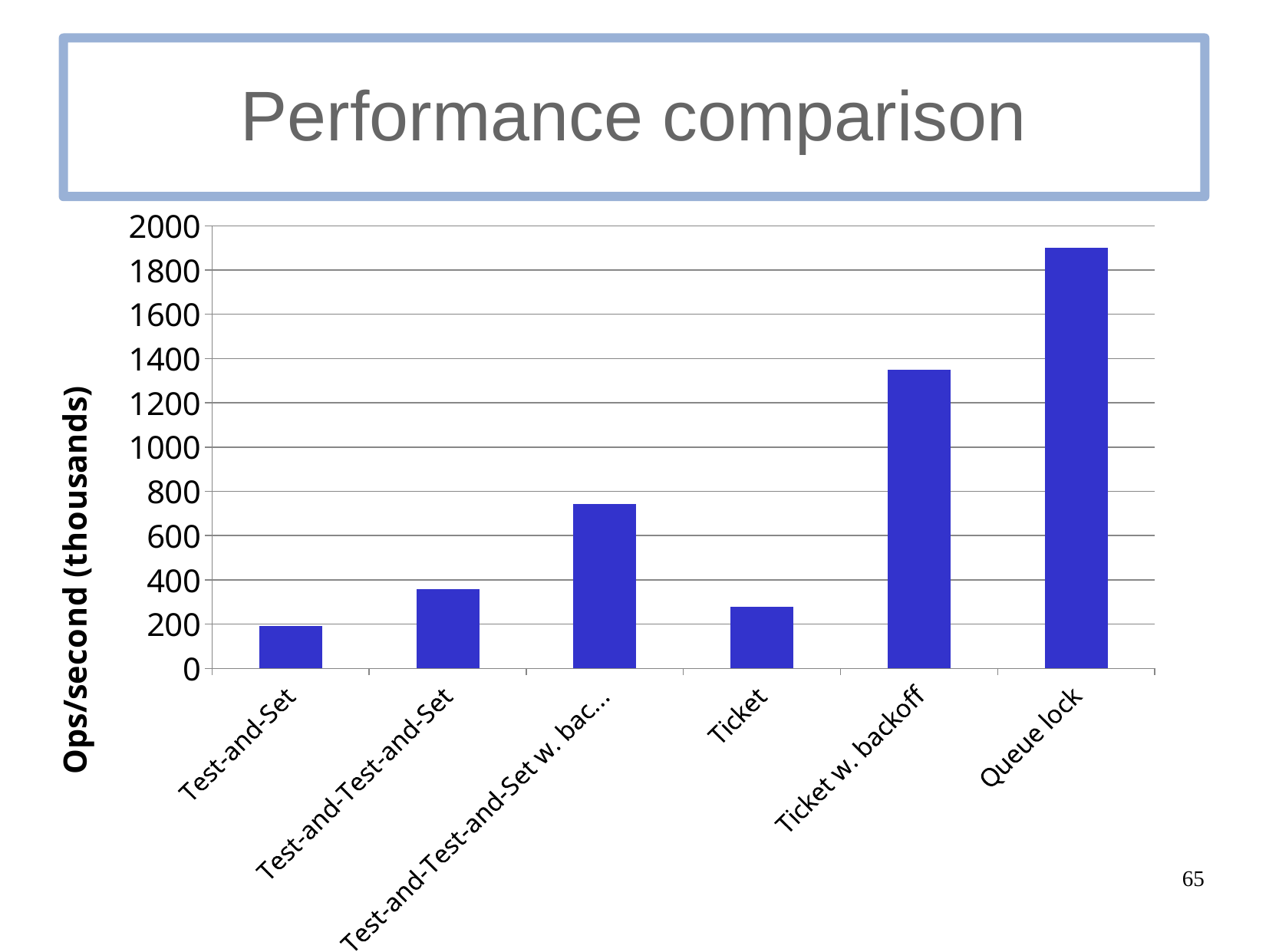
Is the value for Ticket greater or less than 400? less What kind of chart is shown on the slide? bar chart Which is larger, the value for Ticket w. backoff or the value for Queue lock? Queue lock Is the value for Queue lock greater or less than 1800? greater Which is larger, the value for Ticket or the value for Test-and-Test-and-Set? Test-and-Test-and-Set Which category has the highest value? Queue lock Which category has the lowest value? Test-and-Set How many categories (bars) are plotted in the chart? 6 Is the value for Test-and-Test-and-Set w. bac... greater or less than 600? greater What is the label of the vertical axis? Ops/second (thousands)